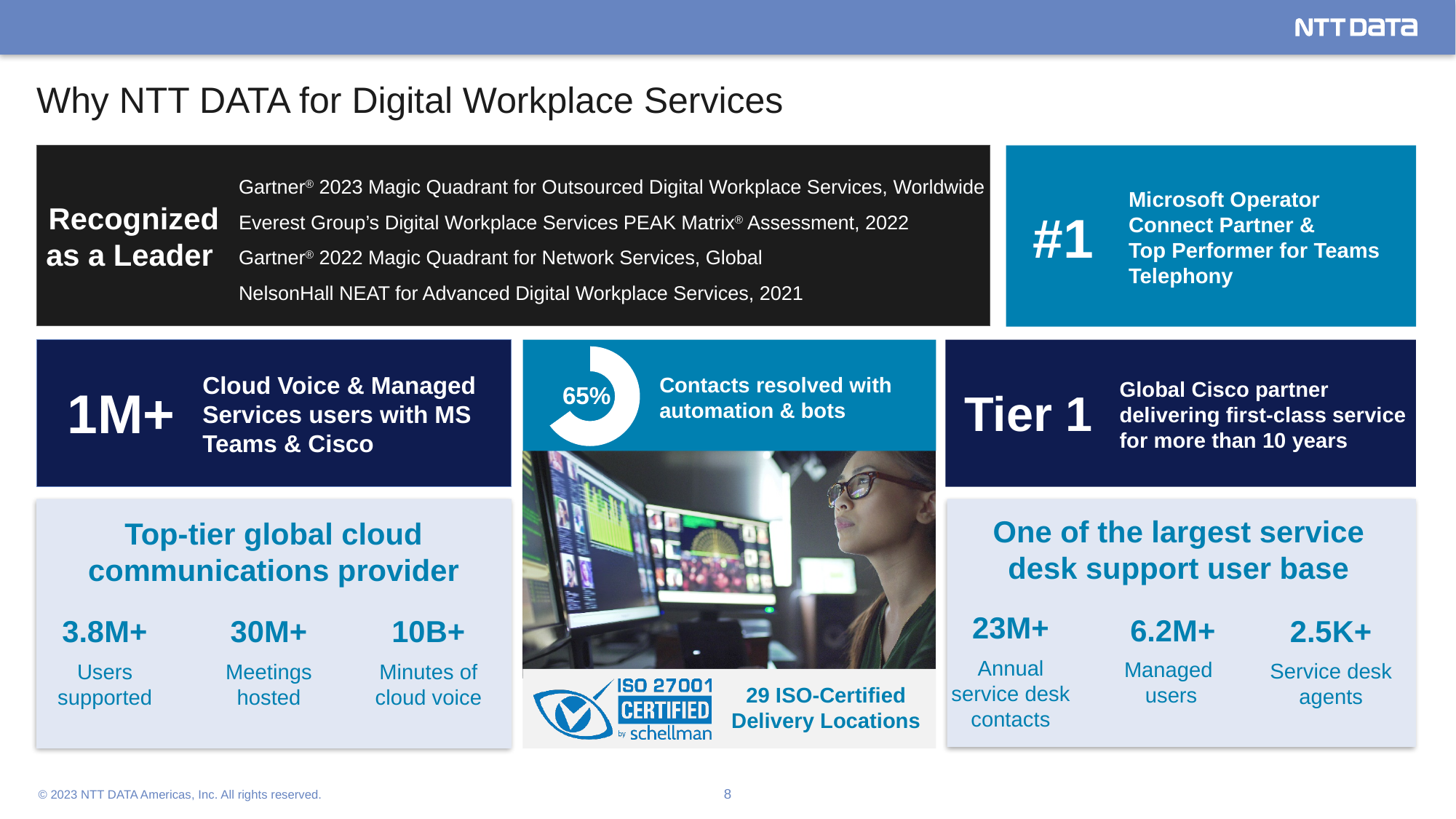
How many data values are labelled on the donut chart? 1 What kind of chart is used to show the 65% figure on the slide? donut chart What share of the donut chart does the highlighted segment represent? 65% What value does the donut chart on the slide show for contacts resolved with automation & bots? 65% What does the 65% donut chart on the slide represent? Contacts resolved with automation & bots